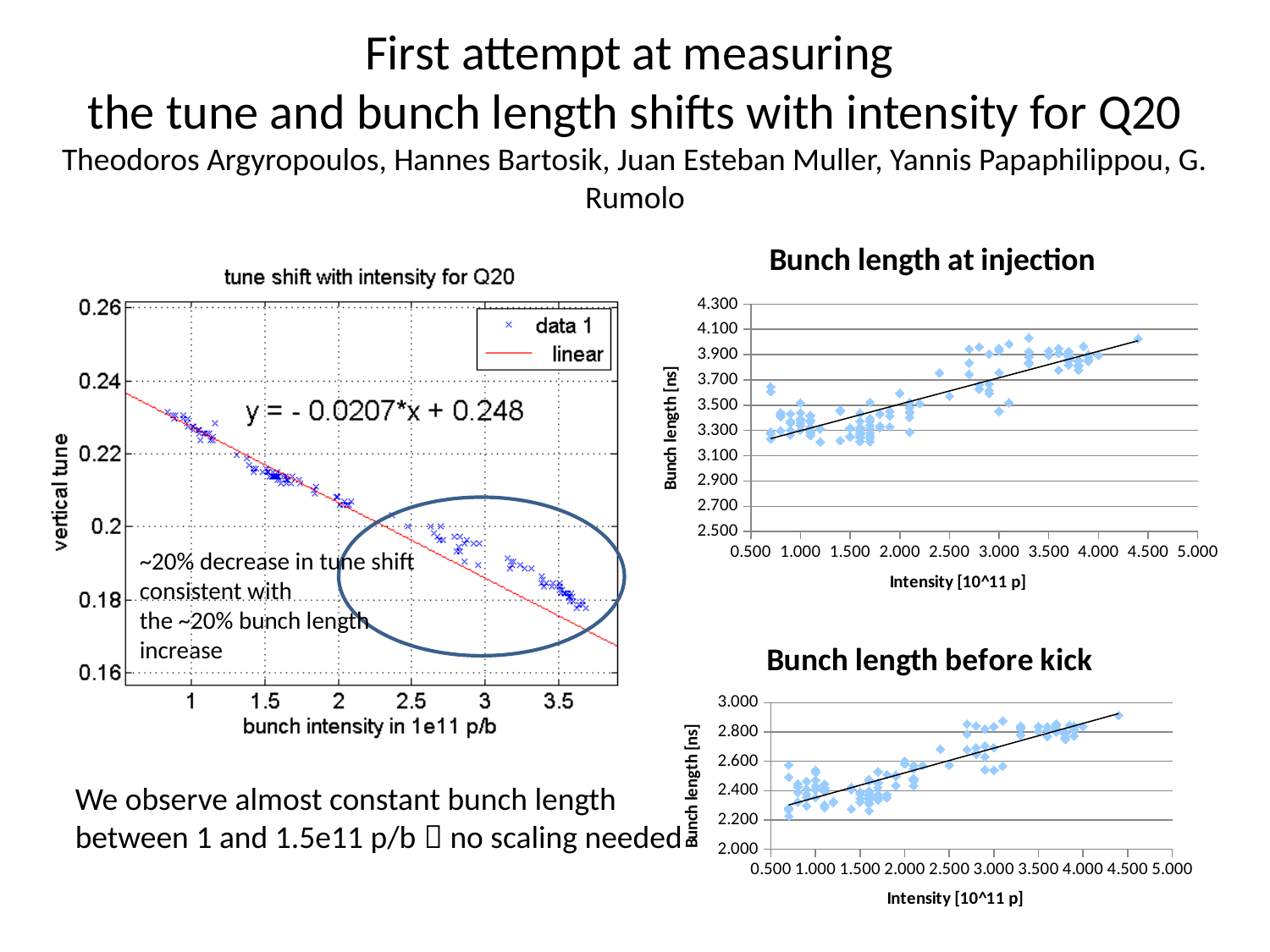
In the "tune shift with intensity for Q20" chart, does the vertical tune rise or fall as bunch intensity increases? fall In the "Bunch length at injection" chart, is the bunch length at the highest intensity (around 4.400) greater or less than 3.500 ns? greater How many series does the legend of the "tune shift with intensity for Q20" chart list? 2 What is the x-axis title of the "Bunch length before kick" chart? Intensity [10^11 p] What kind of chart is the "Bunch length at injection" chart? scatter chart What is the intercept of the linear fit equation shown in the "tune shift with intensity for Q20" chart? 0.248 In the "Bunch length before kick" chart, do bunch length values rise or fall as intensity increases? rise What are the two legend entries in the "tune shift with intensity for Q20" chart? data 1 and linear In the "Bunch length before kick" chart, is the bunch length at the highest intensity (around 4.400) greater or less than 2.600 ns? greater What is the slope of the linear fit shown in the "tune shift with intensity for Q20" chart? -0.0207